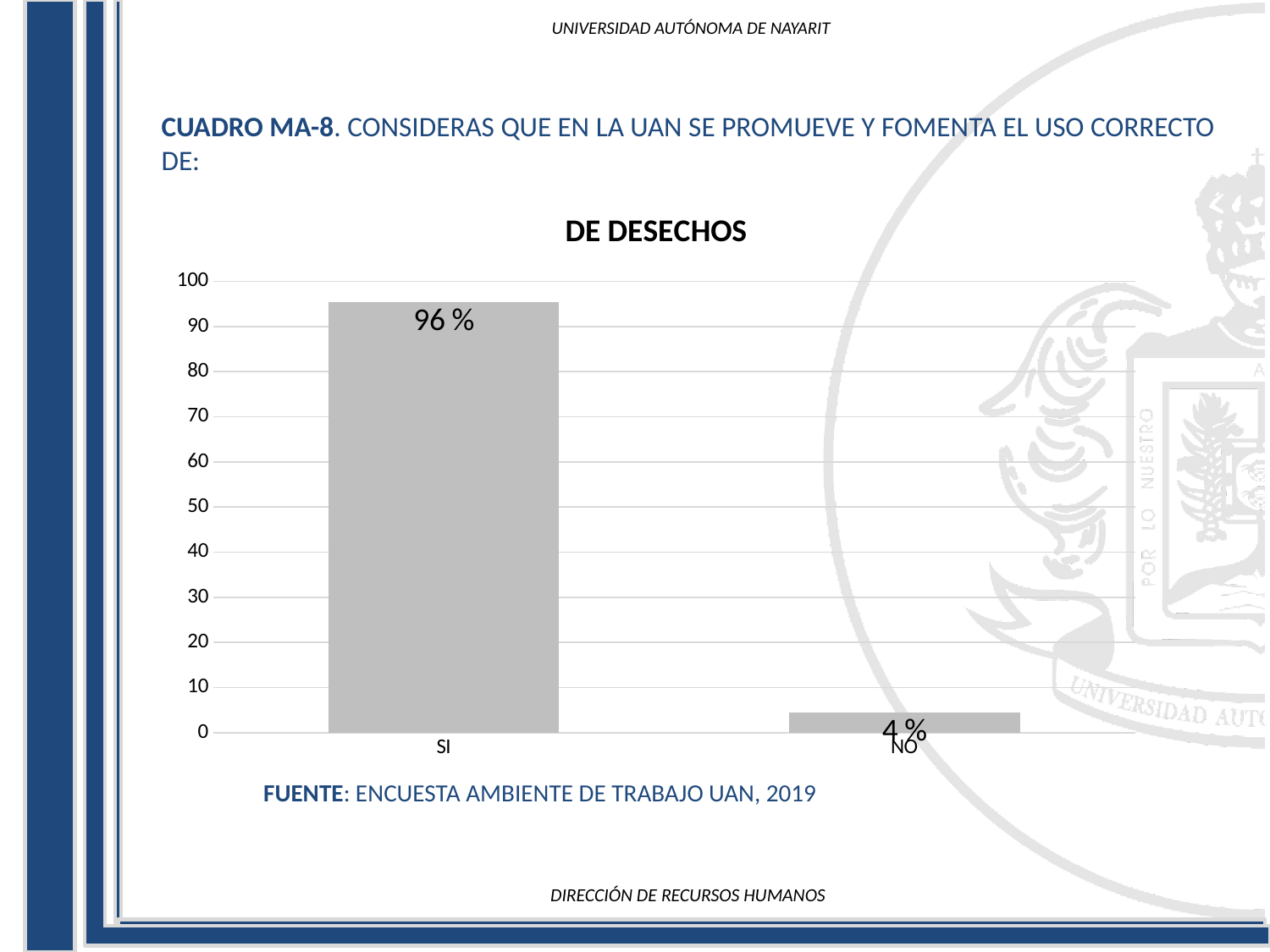
How many categories are shown on the x axis? 2 What kind of chart is shown? bar chart Which category has the highest value? SI Is the value for NO greater or less than 10? less What is the value for SI? 96 % Is the value for SI greater or less than 90? greater Which is larger, the value for SI or the value for NO? SI What is the highest value shown on the y axis? 100 Which category has the lowest value? NO What is the title of the chart? DE DESECHOS What is the value for NO? 4 % What is the difference between the values for SI and NO? 92 %